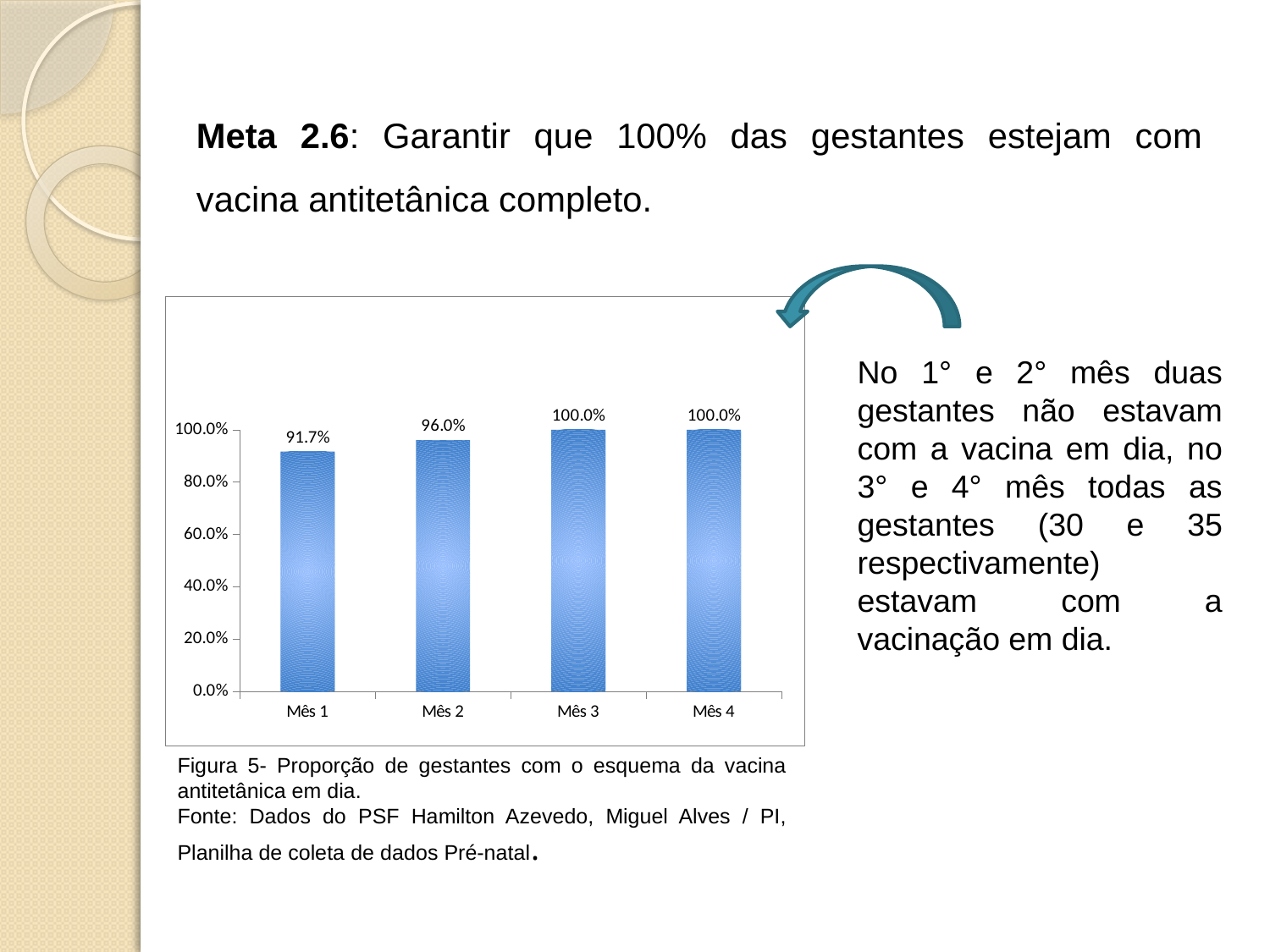
What is the difference between the values for Mês 2 and Mês 1? 4.3% What is the difference between the values for Mês 3 and Mês 2? 4.0% What is the value for Mês 3? 100.0% Which is larger, the value for Mês 1 or the value for Mês 2? Mês 2 How many months are shown on the x axis? 4 Do the values rise or fall from Mês 1 to Mês 3? rise What is the highest value shown on the y axis? 100.0% What is the value for Mês 1? 91.7% Is the value for Mês 1 greater or less than 80.0%? greater What kind of chart is shown on the slide? bar chart Which month has the lowest value? Mês 1 What is the value for Mês 2? 96.0%